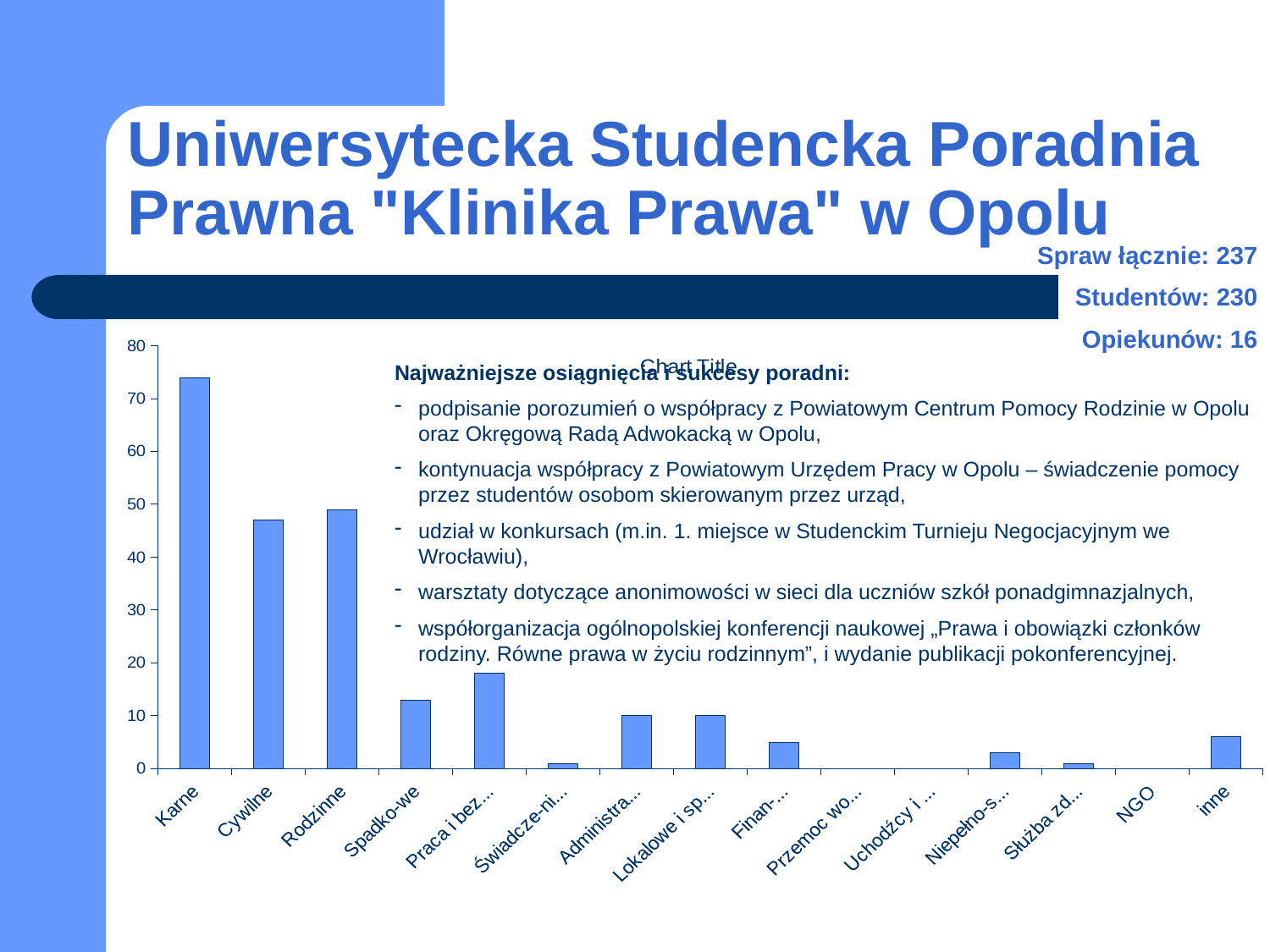
Which is larger, the value for Karne or the value for Cywilne? Karne Which category has the highest bar in the chart? Karne Is the value for Praca i bez... greater or less than 20? less Is the value for Spadko-we greater or less than 10? greater How many categories are shown on the x axis of the chart? 15 Is the value for Cywilne greater or less than 50? less What kind of chart is shown on the slide? bar chart What is the title shown above the chart? Chart Title Which is larger, the value for Praca i bez... or the value for Spadko-we? Praca i bez...